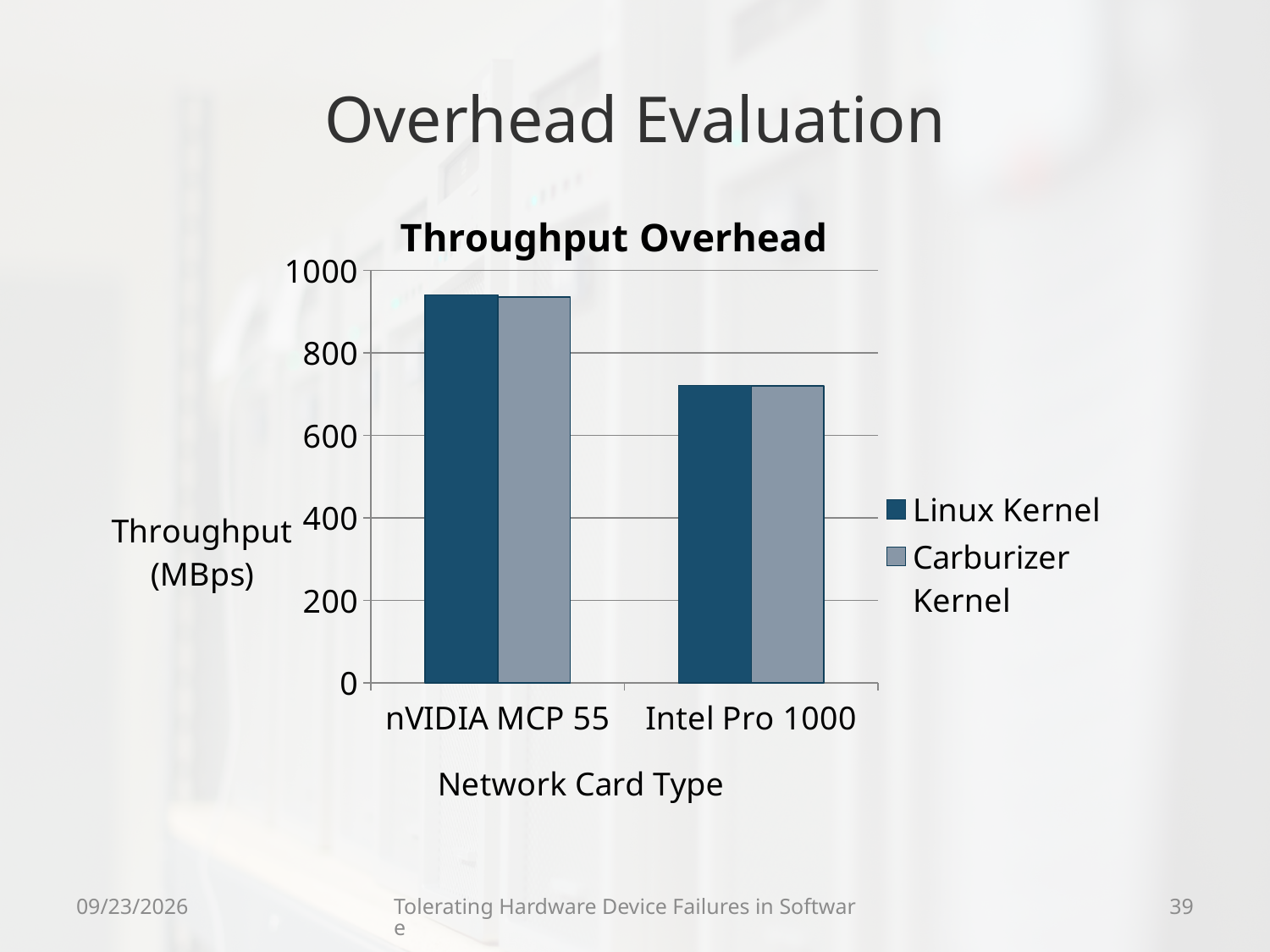
Is the Linux Kernel value for nVIDIA MCP 55 greater or less than 800? greater For the Carburizer Kernel, is the throughput larger for nVIDIA MCP 55 or Intel Pro 1000? nVIDIA MCP 55 How many series does the legend list? 2 Is the Carburizer Kernel value for Intel Pro 1000 greater or less than 800? less What is the title of the chart? Throughput Overhead Is the Carburizer Kernel value for nVIDIA MCP 55 greater or less than 1000? less Which series are listed in the legend? Linux Kernel, Carburizer Kernel Which network card type has the lower Carburizer Kernel throughput? Intel Pro 1000 What type of chart is shown on the slide? bar chart How many network card types are shown on the x axis? 2 Which network card type has the higher Linux Kernel throughput? nVIDIA MCP 55